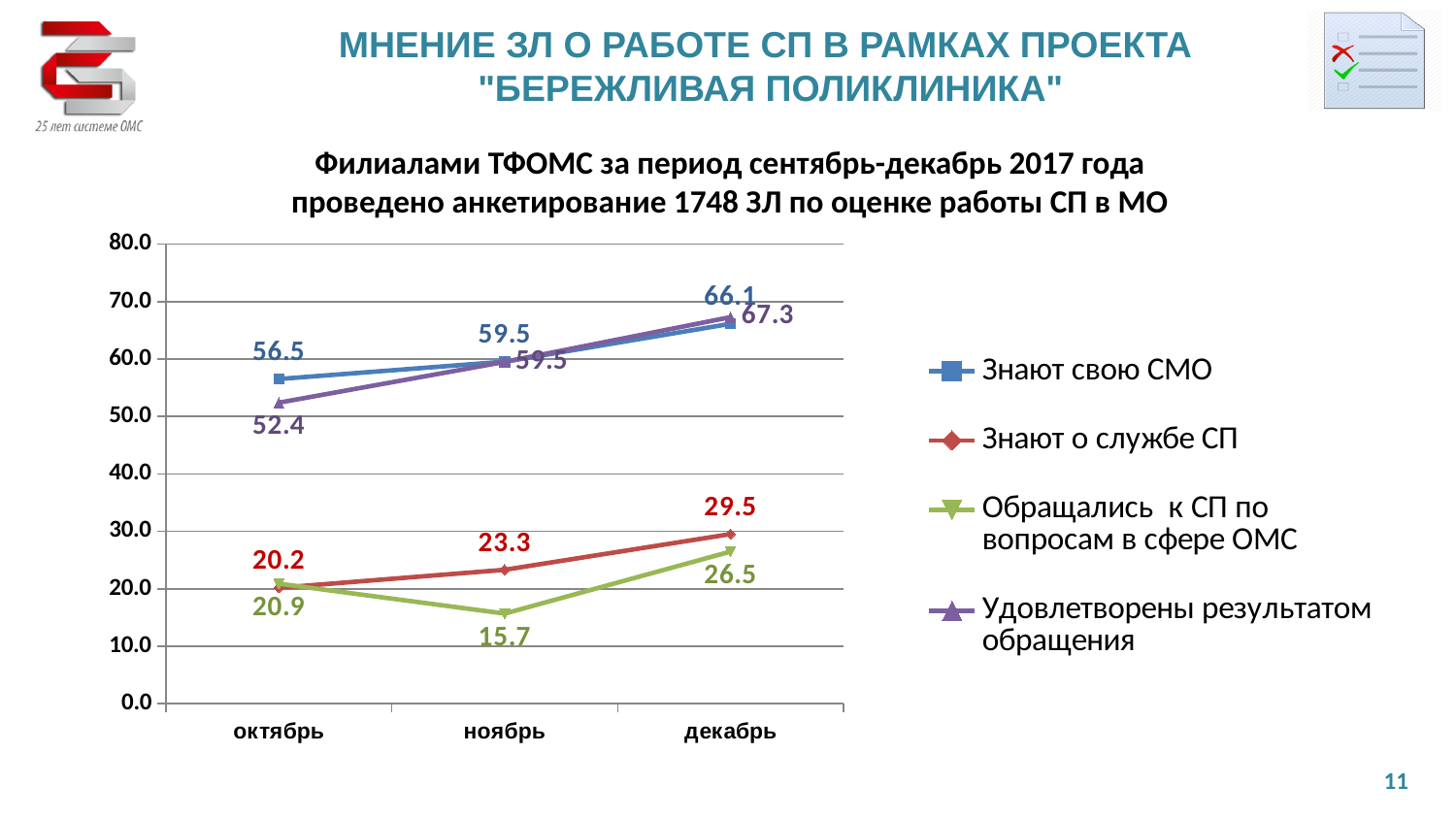
In which month is the value for "Обращались к СП по вопросам в сфере ОМС" lowest? ноябрь How many series does the legend list? 4 How many categories are shown on the x axis? 3 What is the value for "Обращались к СП по вопросам в сфере ОМС" in ноябрь? 15.7 Which is larger in октябрь: "Знают свою СМО" or "Удовлетворены результатом обращения"? Знают свою СМО Do the values for "Знают о службе СП" rise or fall from октябрь to декабрь? rise What is the value for "Удовлетворены результатом обращения" in декабрь? 67.3 What kind of chart is shown on the slide? line chart What is the value for "Знают свою СМО" in октябрь? 56.5 In which month is the value for "Знают свою СМО" highest? декабрь What is the value for "Знают о службе СП" in декабрь? 29.5 What is the difference between the "Знают о службе СП" values in декабрь and октябрь? 9.3